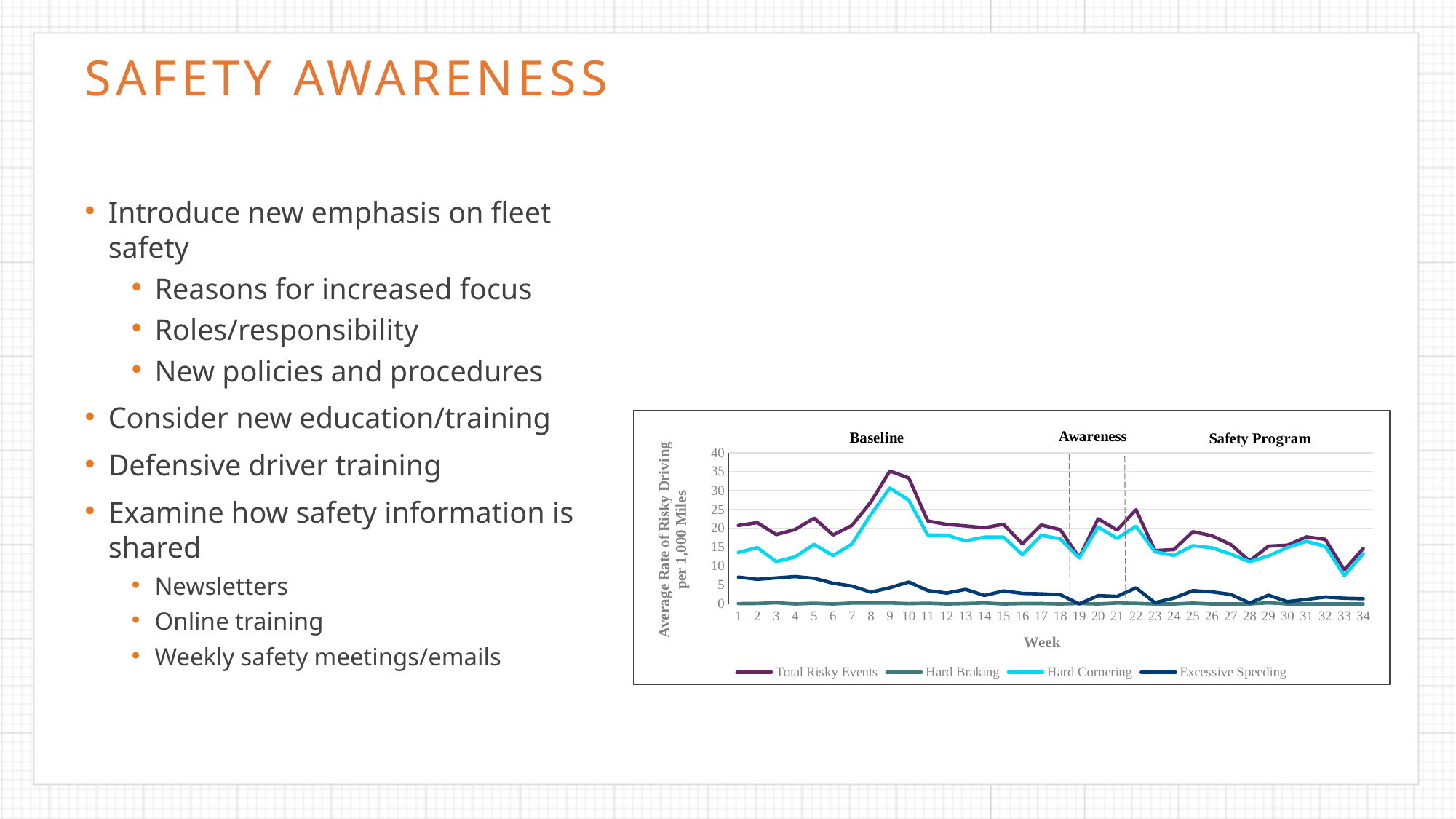
What is the title of the chart's y axis? Average Rate of Risky Driving per 1,000 Miles Is the value of Total Risky Events in week 9 greater or less than 30? greater In which week does the Total Risky Events series reach its highest value? Week 9 Which series is higher in week 9, Hard Cornering or Excessive Speeding? Hard Cornering Does the Excessive Speeding series generally rise or fall from week 1 to week 34? fall What are the three phases labelled above the chart? Baseline, Awareness, Safety Program What kind of chart is shown on the slide? line chart How many series does the chart's legend list? 4 How many weeks are plotted along the x axis of the chart? 34 Is the value of Excessive Speeding in week 1 greater or less than 10? less Is the value of Hard Cornering in week 33 greater or less than 10? less Which series stays lowest across all weeks, closest to 0? Hard Braking